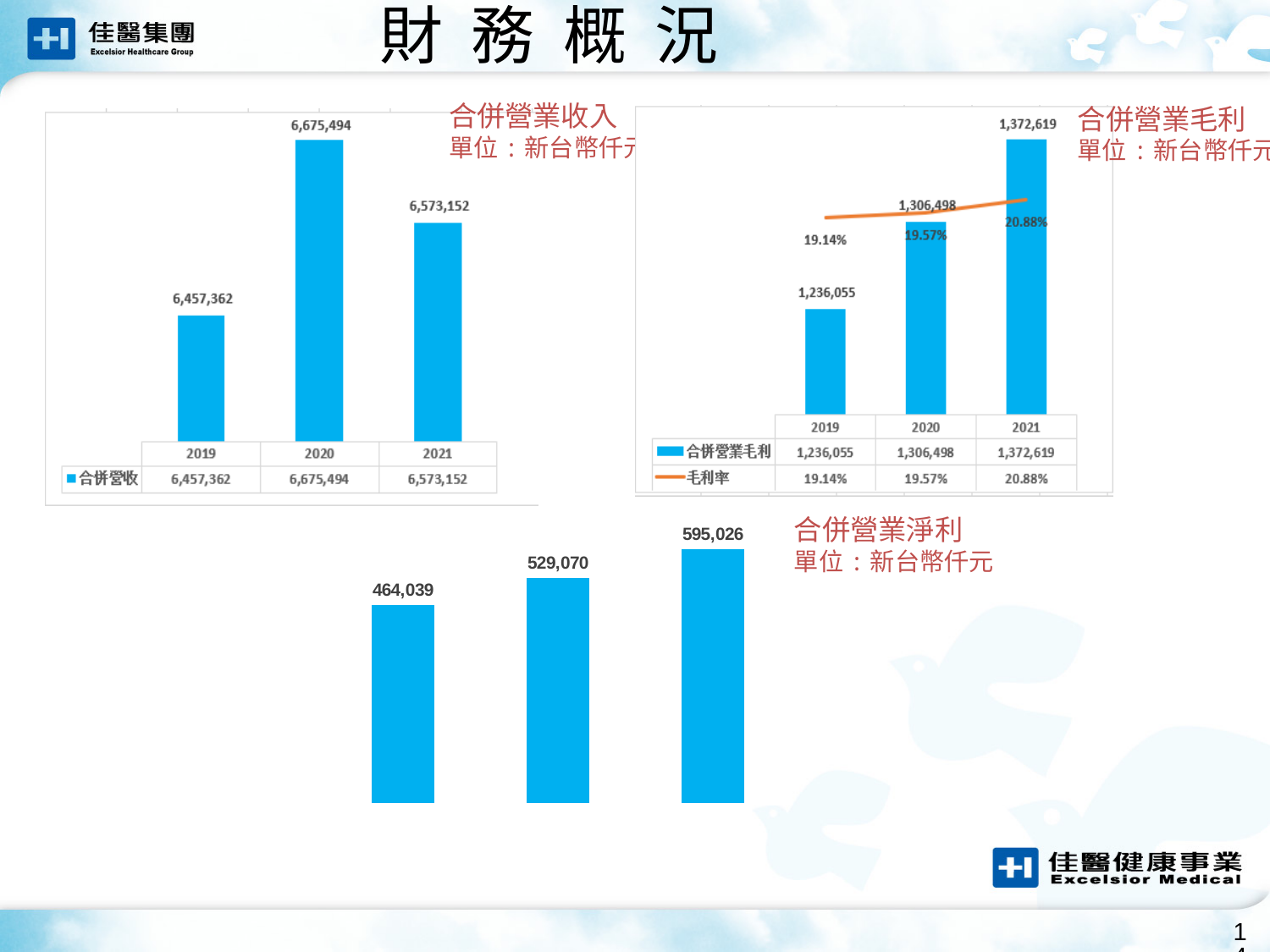
In the 合併營業收入 chart, what is the value for 2020? 6,675,494 In the 合併營業淨利 chart at the bottom, what is the value of the tallest bar? 595,026 In the 合併營業收入 chart, which year has the lowest value? 2019 In the 合併營業毛利 chart, what is the difference between the 2021 and 2019 合併營業毛利 values? 136,564 What kind of chart is the 合併營業收入 chart? bar chart In the 合併營業毛利 chart, what is the 合併營業毛利 value for 2021? 1,372,619 In the 合併營業收入 chart, what is the difference between the 2020 and 2021 values? 102,342 In the 合併營業毛利 chart, does the 毛利率 rise or fall from 2019 to 2021? rise In the 合併營業毛利 chart, how many series does the legend list? 2 In the 合併營業淨利 chart at the bottom, how many bars are plotted? 3 In the 合併營業毛利 chart, what is the 毛利率 for 2019? 19.14% In the 合併營業淨利 chart at the bottom, do the values rise or fall from left to right? rise